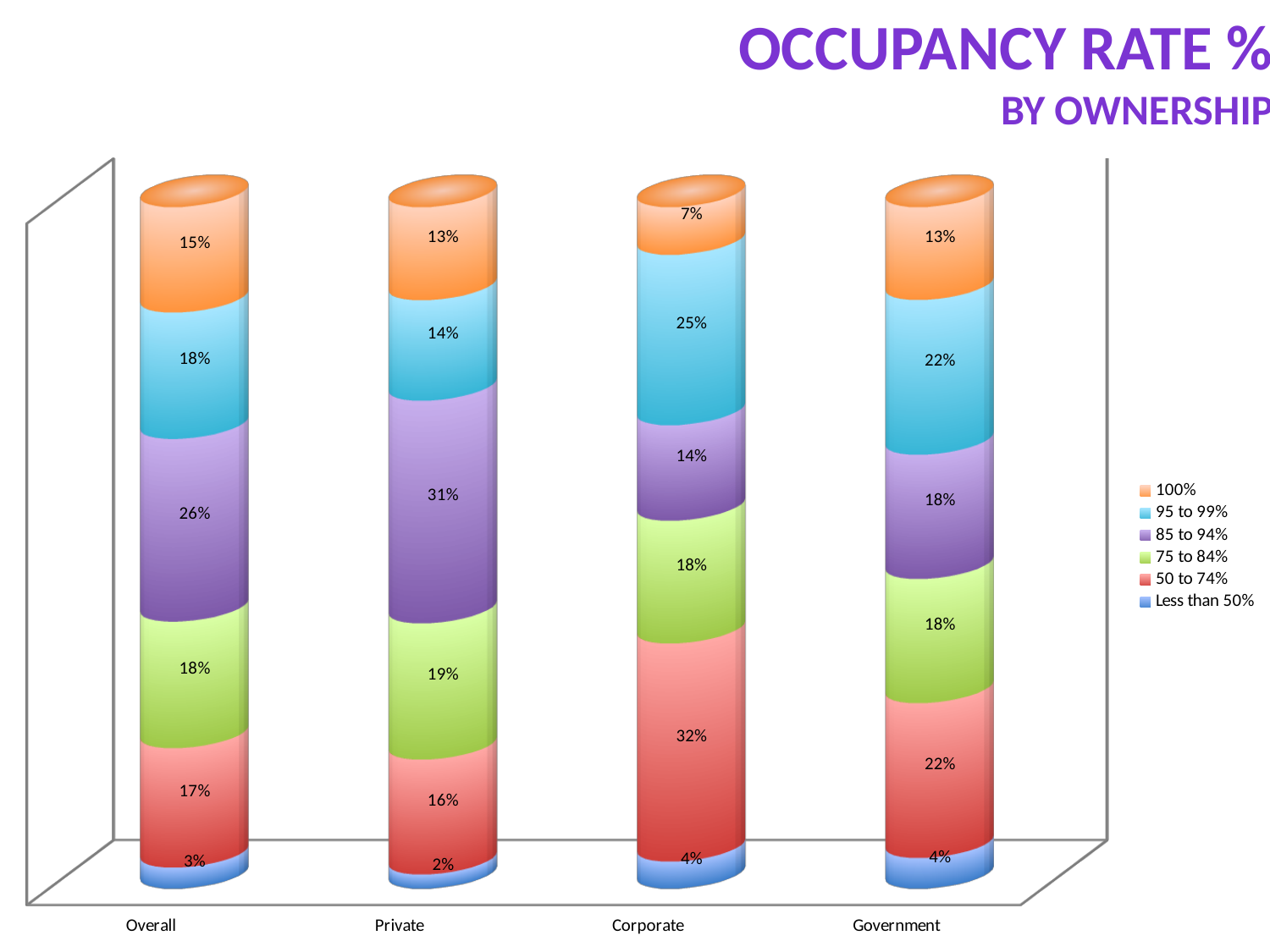
Which is larger: the 50 to 74% segment for Government or for Overall? Government How many series does the legend list? 6 Which legend entry is shown in orange? 100% How many ownership categories are shown on the x axis? 4 What is the difference between the 85 to 94% segment for Private and for Corporate? 17% What is the value of the Less than 50% segment for Overall? 3% What kind of chart is shown on the slide? Stacked bar chart What is the value of the 85 to 94% segment for Private? 31% What is the value of the 50 to 74% segment for Corporate? 32% Which ownership category has the lowest value for the 100% segment? Corporate Which ownership category has the highest value for the 95 to 99% segment? Corporate What is the value of the 100% segment for Government? 13%